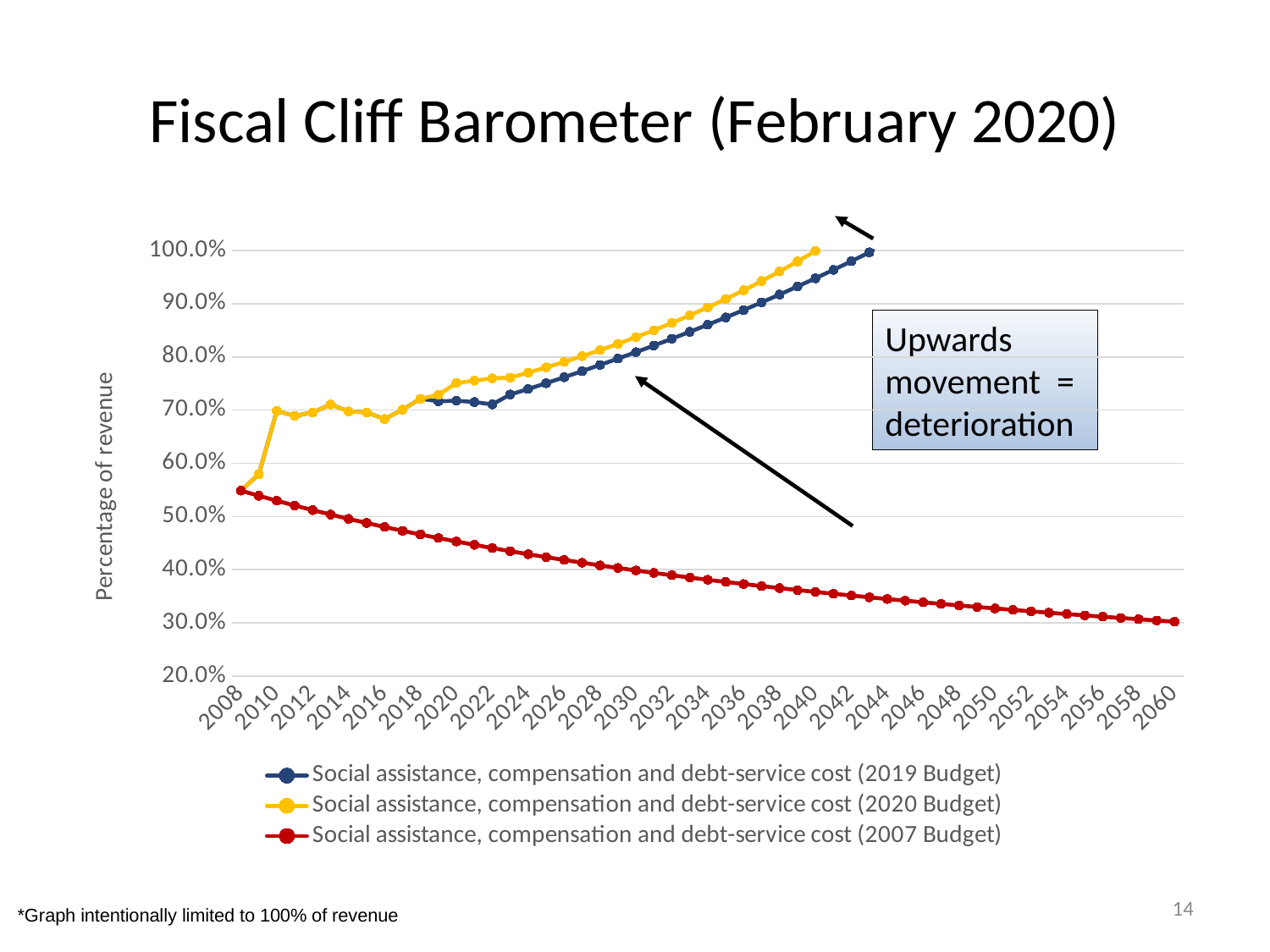
How many series does the legend list? 3 What is the label on the vertical axis? Percentage of revenue Does the 'Social assistance, compensation and debt-service cost (2020 Budget)' series rise or fall overall from 2008 to 2040? Rise Which series has the lowest value in 2050? Social assistance, compensation and debt-service cost (2007 Budget) Is the value for the 2019 Budget series in 2040 greater or less than 90.0%? greater What kind of chart is shown on the slide? Line chart What is the title of the chart? Fiscal Cliff Barometer (February 2020) Does the 'Social assistance, compensation and debt-service cost (2007 Budget)' series rise or fall from 2008 to 2060? Fall Is the value for the 2007 Budget series in 2020 greater or less than 50.0%? less Is the value for the 2020 Budget series in 2040 greater or less than 90.0%? greater In 2030, which series has the higher value: the 2019 Budget series or the 2020 Budget series? 2020 Budget series